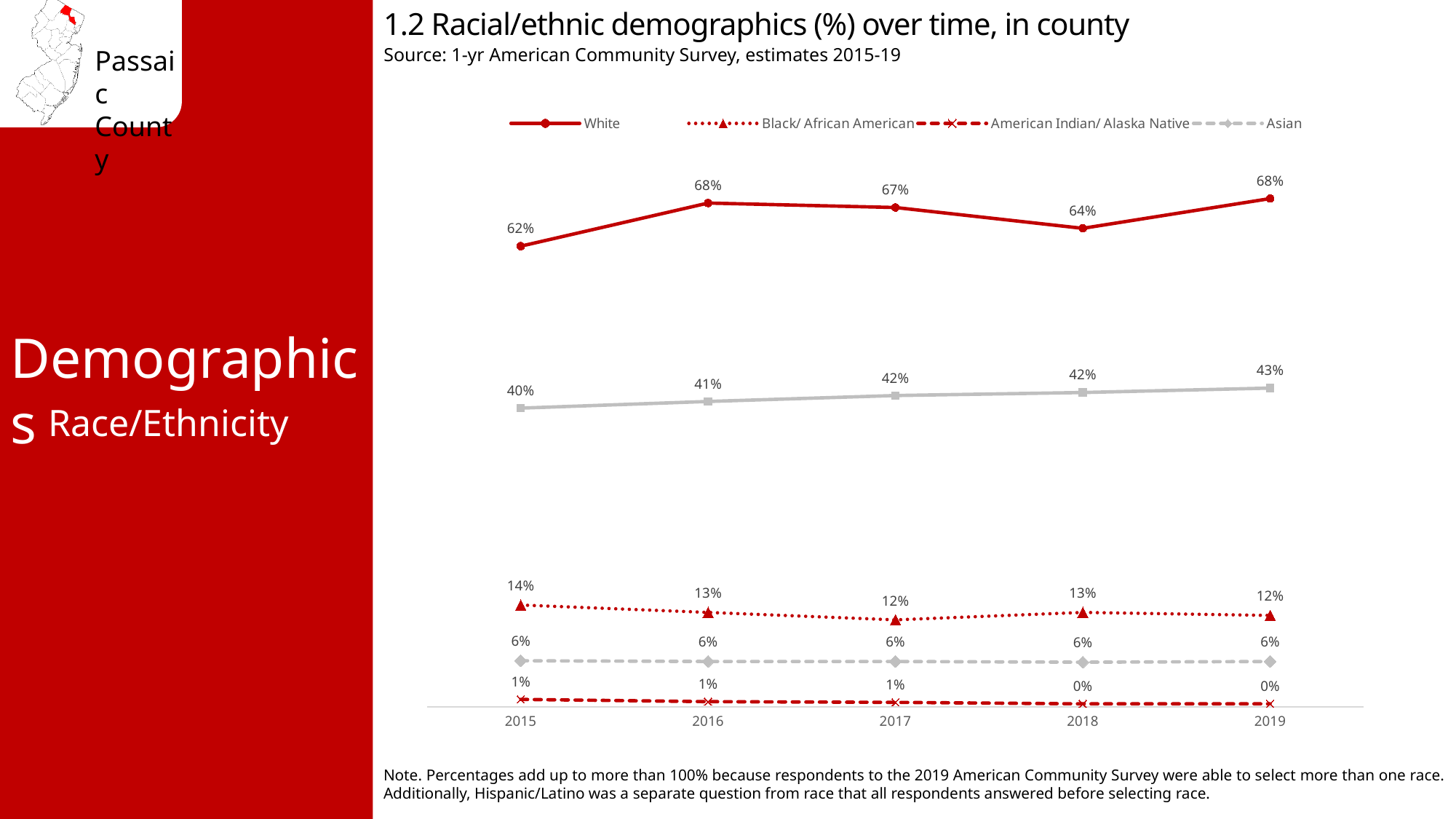
What kind of chart is shown on the slide? Line chart What is the value for Asian in 2018? 6% In which year is the White series at its lowest? 2015 Does the Black/ African American series rise or fall from 2015 to 2017? Fall What is the value for Black/ African American in 2017? 12% Which is larger, the White value in 2017 or in 2018? 2017 What is the value for White in 2015? 62% What is the value for American Indian/ Alaska Native in 2019? 0% How many years are shown on the x axis? 5 In which year is the Black/ African American series at its highest? 2015 What is the difference between the White values in 2016 and 2015? 6 percentage points What is the value for White in 2019? 68%